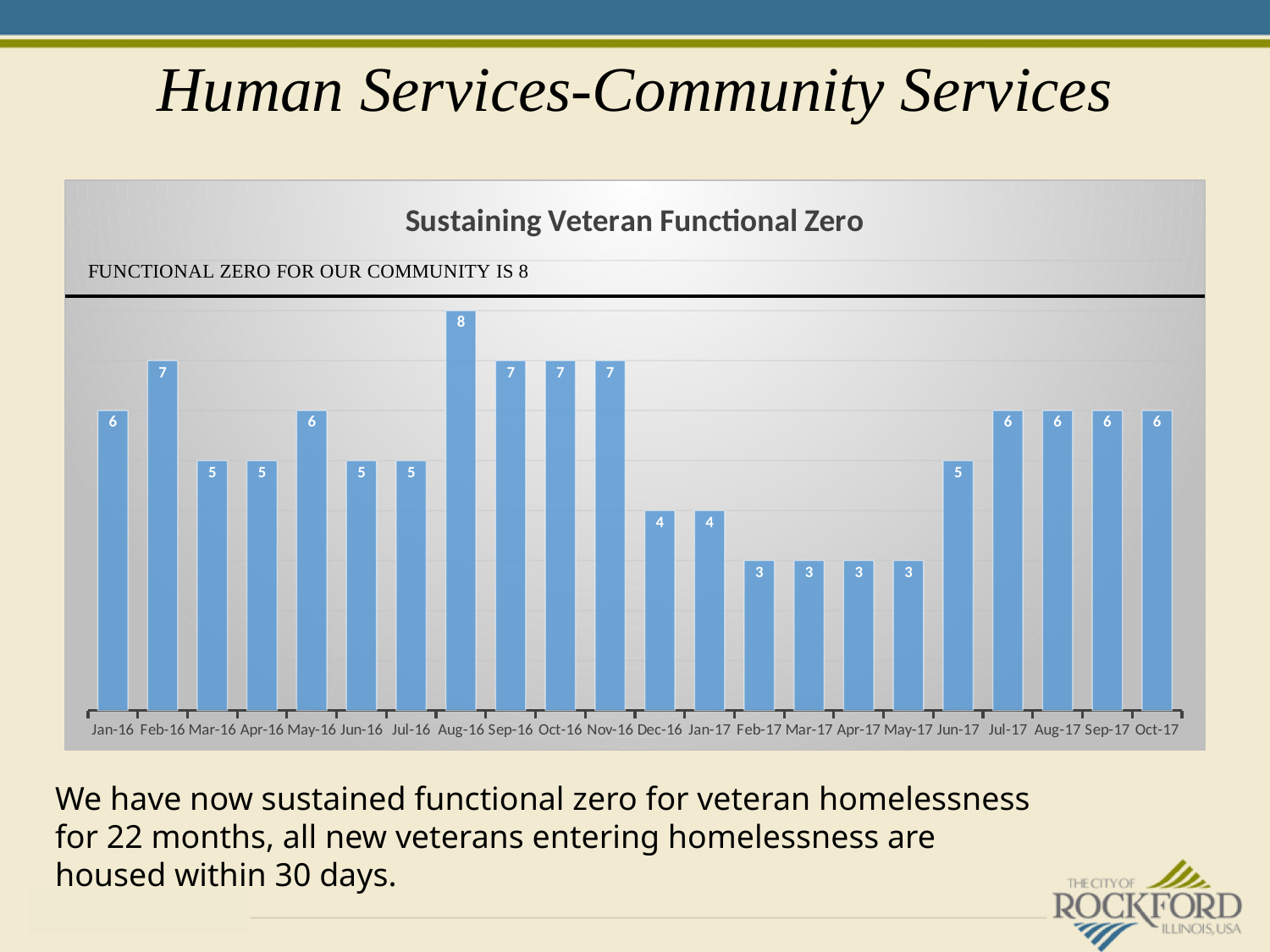
How many months are plotted in the chart? 22 What is the lowest value shown in the chart? 3 According to the text on the chart, what is functional zero for the community? 8 What is the value for Jun-17? 5 What is the value for Dec-16? 4 What is the title of the chart? Sustaining Veteran Functional Zero Do the values rise or fall from Nov-16 to Feb-17? fall What type of chart is shown on the slide? bar chart Which month has the highest value? Aug-16 What is the value for Aug-16? 8 What is the difference between the values for Aug-16 and Feb-17? 5 Which is larger, the value for Feb-16 or the value for Mar-16? Feb-16